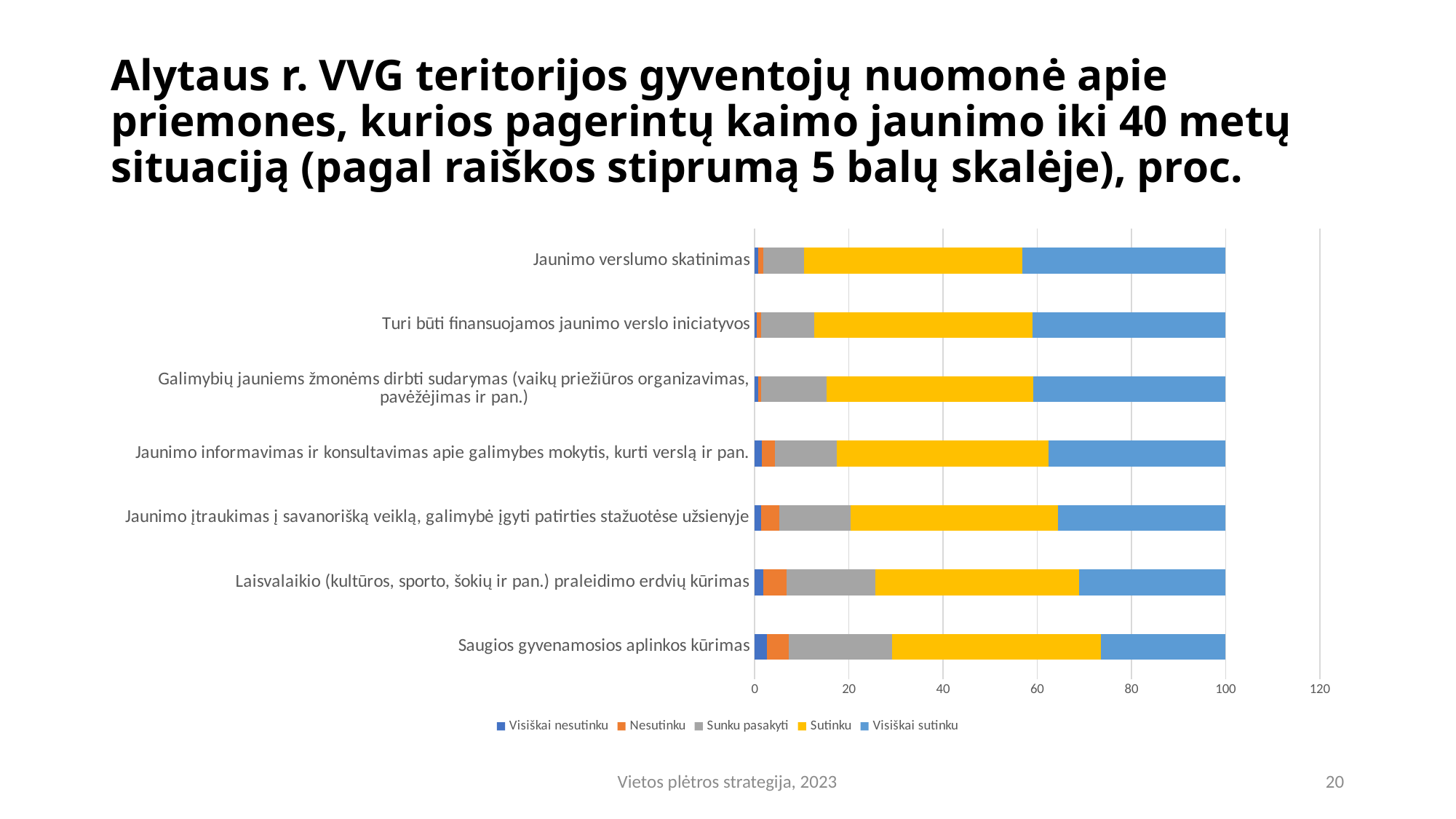
What kind of chart is shown on the slide? Stacked bar chart Which category appears at the top of the chart? Jaunimo verslumo skatinimas Is the 'Visiškai sutinku' value for 'Jaunimo verslumo skatinimas' greater or less than 20? greater How many categories (measures) are listed on the vertical axis of the chart? 7 Which category has the smallest 'Visiškai sutinku' value? Saugios gyvenamosios aplinkos kūrimas Which series is shown in yellow in the chart? Sutinku Which has the larger 'Sunku pasakyti' value: 'Saugios gyvenamosios aplinkos kūrimas' or 'Jaunimo verslumo skatinimas'? Saugios gyvenamosios aplinkos kūrimas Is the 'Sutinku' value for 'Saugios gyvenamosios aplinkos kūrimas' greater or less than 40? greater Is the 'Visiškai sutinku' value for 'Saugios gyvenamosios aplinkos kūrimas' greater or less than 40? less How many series does the chart legend list? 5 Which has the larger 'Visiškai sutinku' value: 'Jaunimo verslumo skatinimas' or 'Saugios gyvenamosios aplinkos kūrimas'? Jaunimo verslumo skatinimas